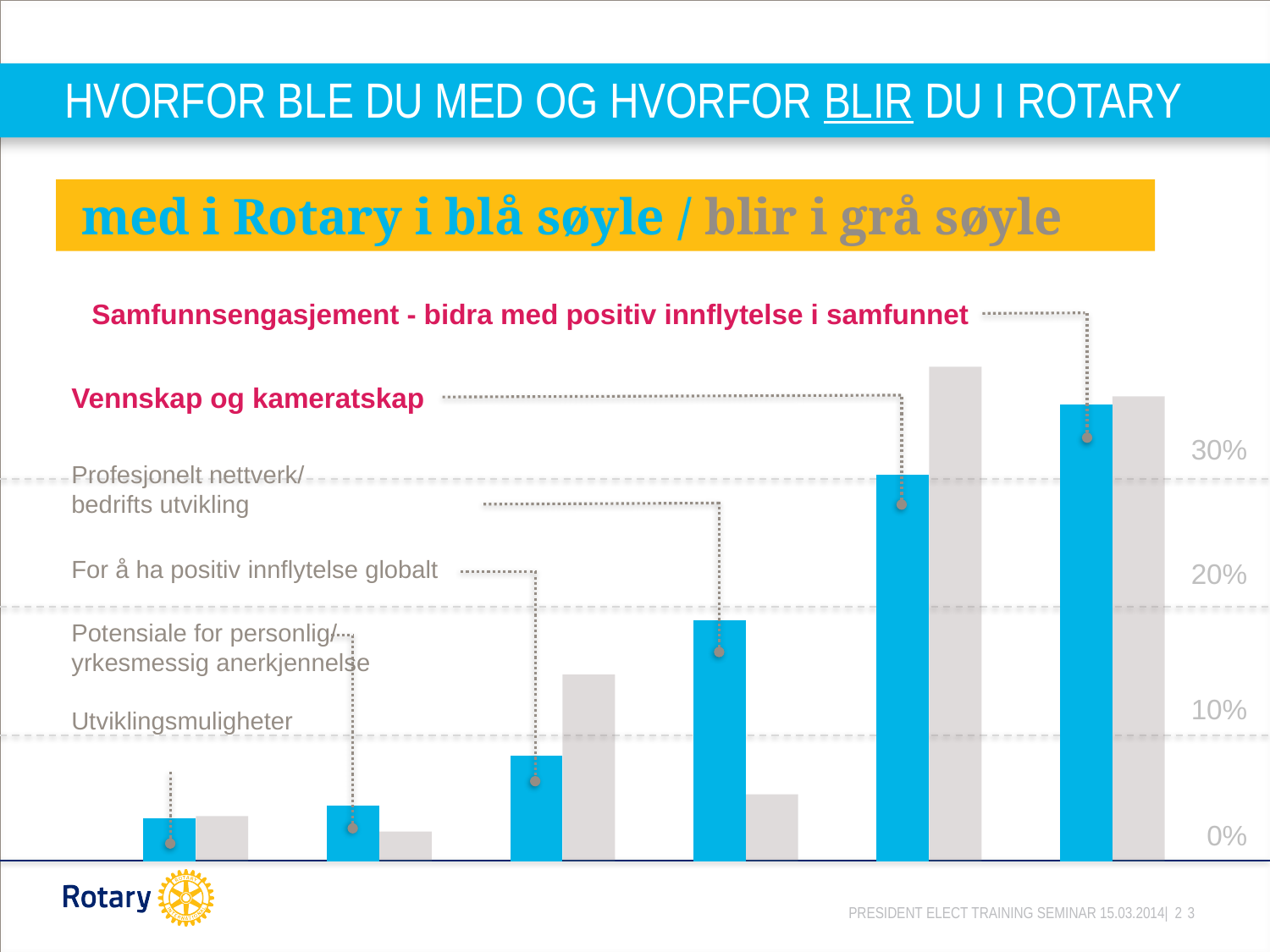
Which category has the highest blue bar? Samfunnsengasjement - bidra med positiv innflytelse i samfunnet Is the grey bar for Vennskap og kameratskap greater or less than 30%? greater How many categories (reasons) are plotted in the chart? 6 Which category has the lowest grey bar? Potensiale for personlig/yrkesmessig anerkjennelse Do the blue bars generally rise or fall from left to right across the chart? rise Which category has the highest grey bar? Vennskap og kameratskap What kind of chart is shown on the slide? bar chart For Profesjonelt nettverk/bedrifts utvikling, which bar is larger, the blue or the grey? blue For For å ha positiv innflytelse globalt, which bar is larger, the blue or the grey? grey How many series does the chart show (as described in the yellow banner)? 2 Is the grey bar for Profesjonelt nettverk/bedrifts utvikling greater or less than 10%? less Is the blue bar for For å ha positiv innflytelse globalt greater or less than 10%? less